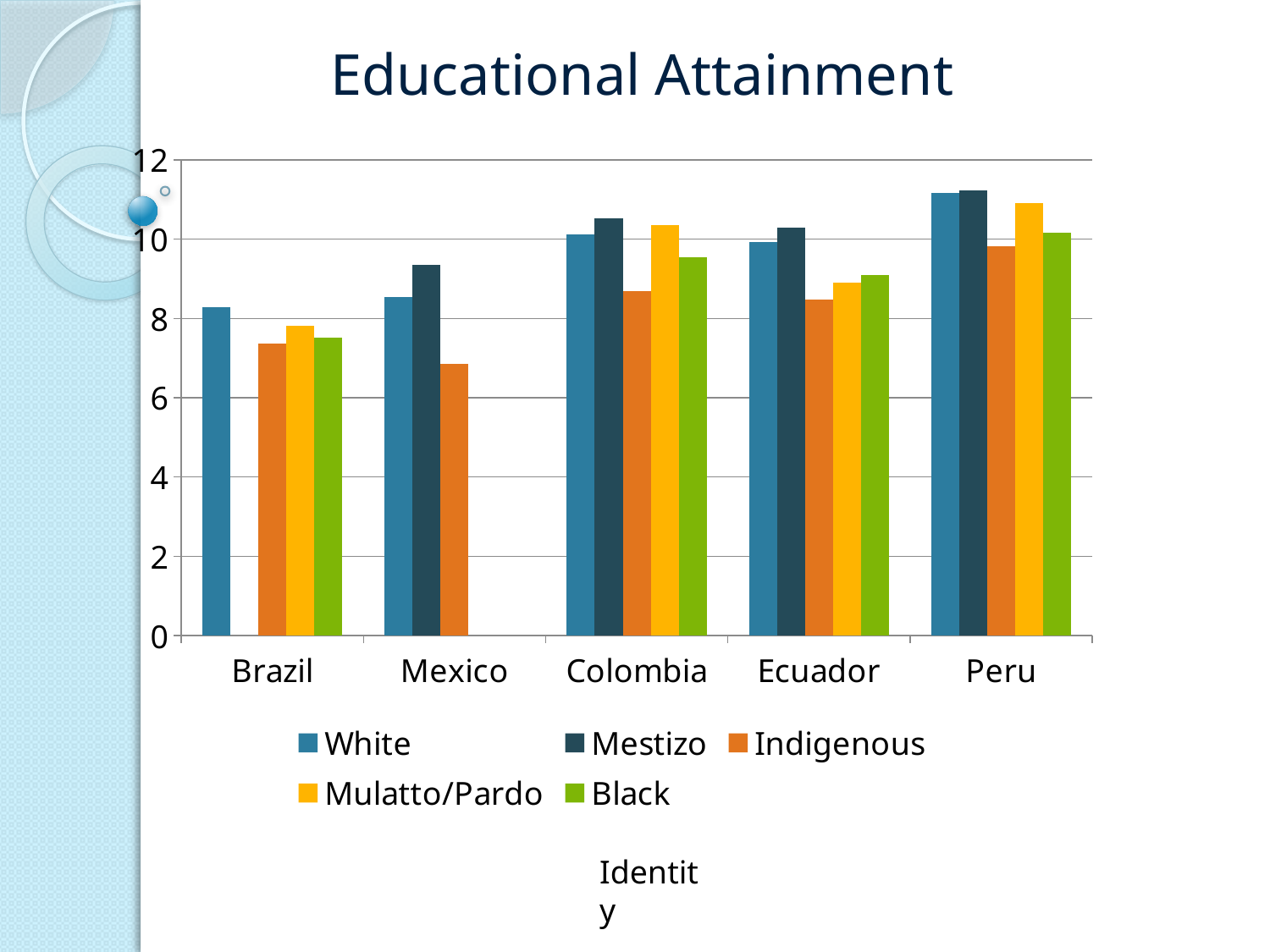
How many countries are shown on the x axis? 5 Is the value for Mestizo in Peru greater or less than 10? greater Is the value for Black in Colombia greater or less than 10? less Is the value for Indigenous in Mexico greater or less than 8? less In Colombia, which is larger: the Mestizo bar or the Indigenous bar? Mestizo Which country has the highest White bar? Peru In Brazil, which is larger: the White bar or the Black bar? White How many series does the legend list? 5 Which country has the lowest Indigenous bar? Mexico What is the title of the chart? Educational Attainment What is the label on the x axis of the chart? Identity What kind of chart is shown on the slide? bar chart